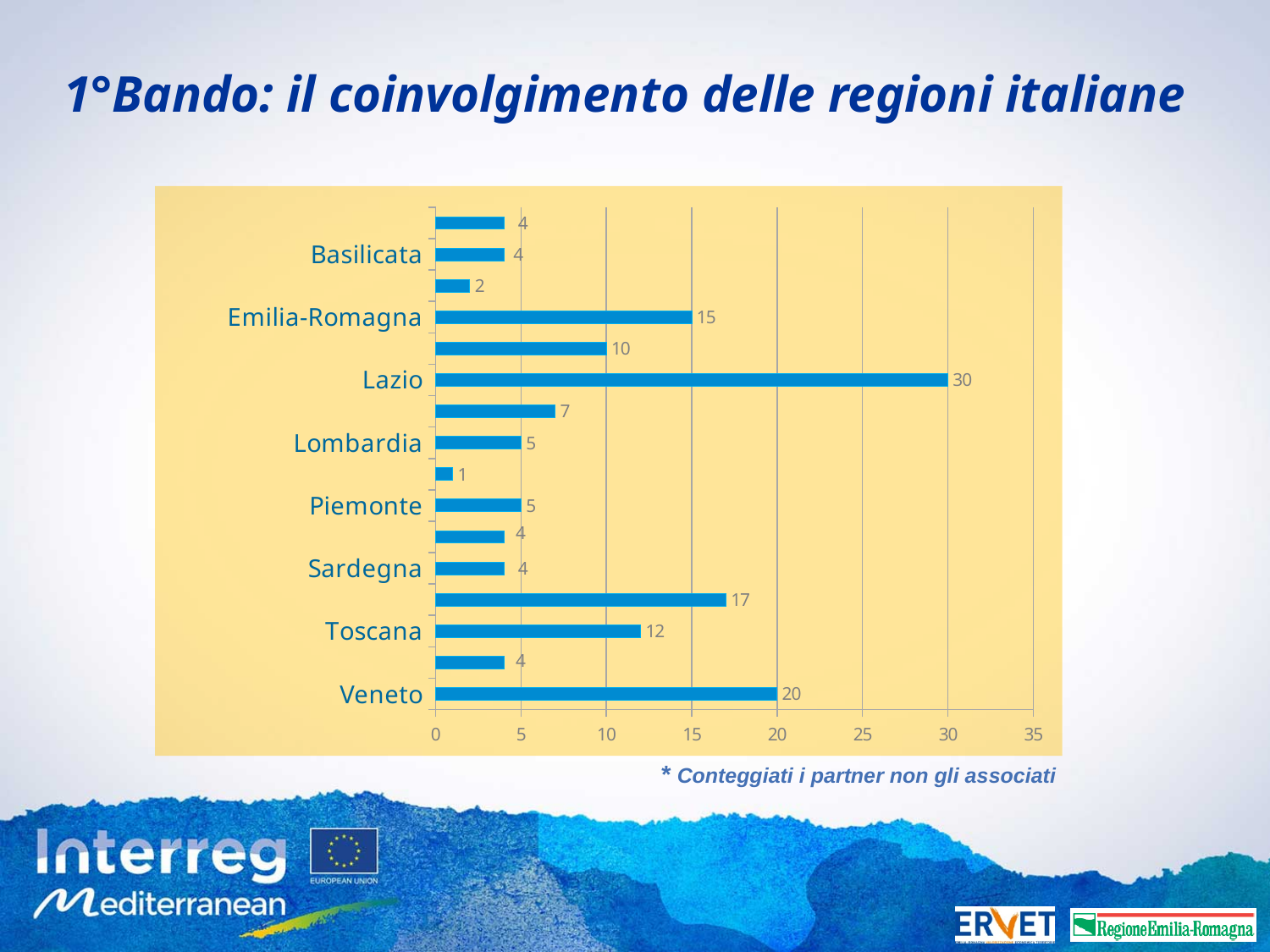
What is the value for Sardegna? 4 Is the value for Lombardia greater or less than 10? less What kind of chart is shown on the slide? bar chart What is the value for Veneto? 20 How many bars are plotted in the chart? 16 What is the title of the slide? 1°Bando: il coinvolgimento delle regioni italiane Which is larger, the value for Toscana or the value for Emilia-Romagna? Emilia-Romagna What is the difference between the values for Lazio and Veneto? 10 What is the value for Lazio? 30 What is the value for Emilia-Romagna? 15 Which labelled region has the highest value? Lazio What is the value for Toscana? 12